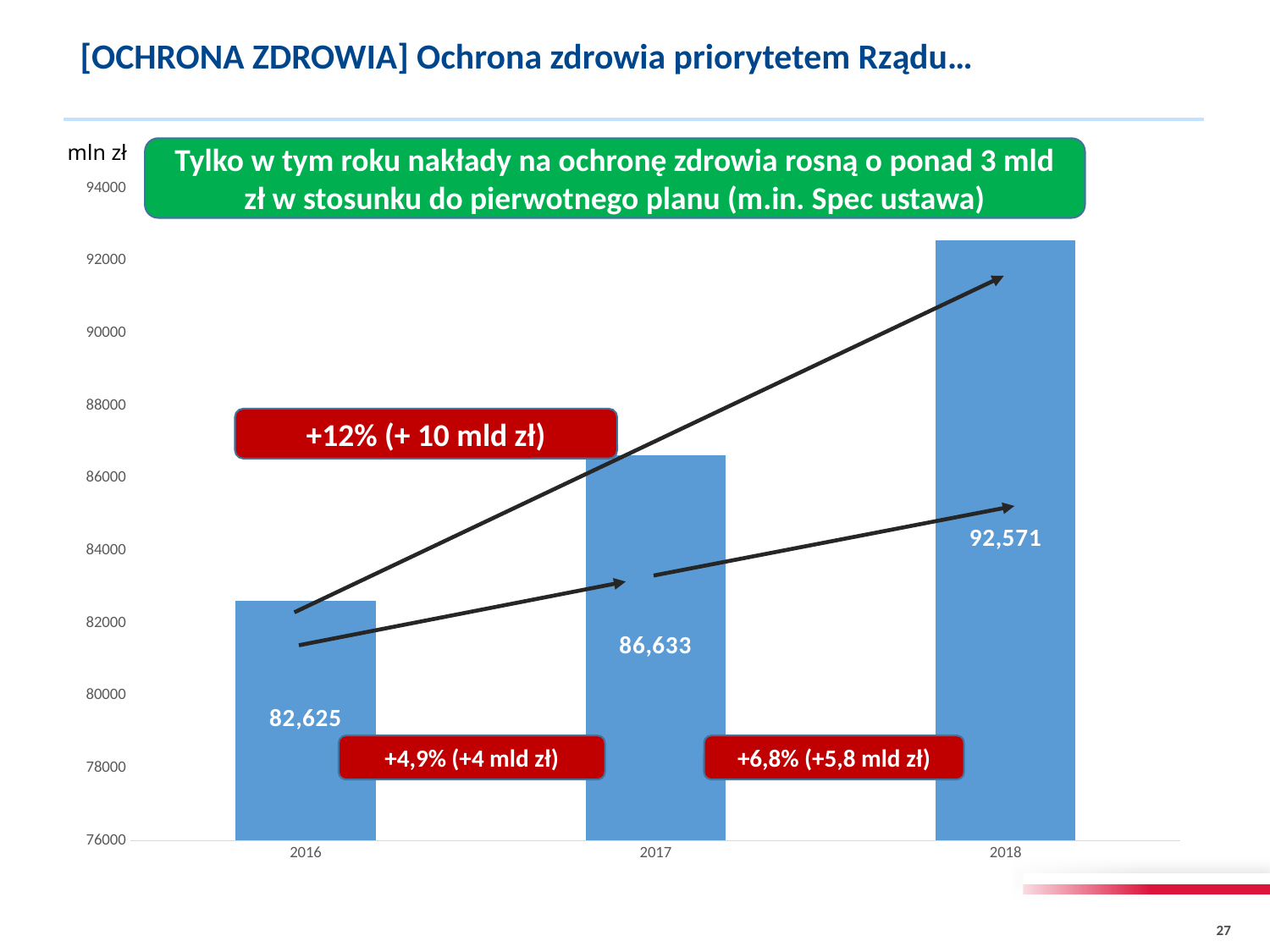
What is the value for 2018? 92,571 What is the difference between the values for 2018 and 2017? 5,938 What is the difference between the values for 2017 and 2016? 4,008 Which year has the lowest value? 2016 What is the value for 2017? 86,633 Do the values rise or fall from 2016 to 2018? rise Which year has the highest value? 2018 What kind of chart is shown on the slide? bar chart How many years are shown on the x axis? 3 Which is larger, the value for 2017 or the value for 2018? 2018 What is the value for 2016? 82,625 Is the value for 2016 greater or less than 84000? less